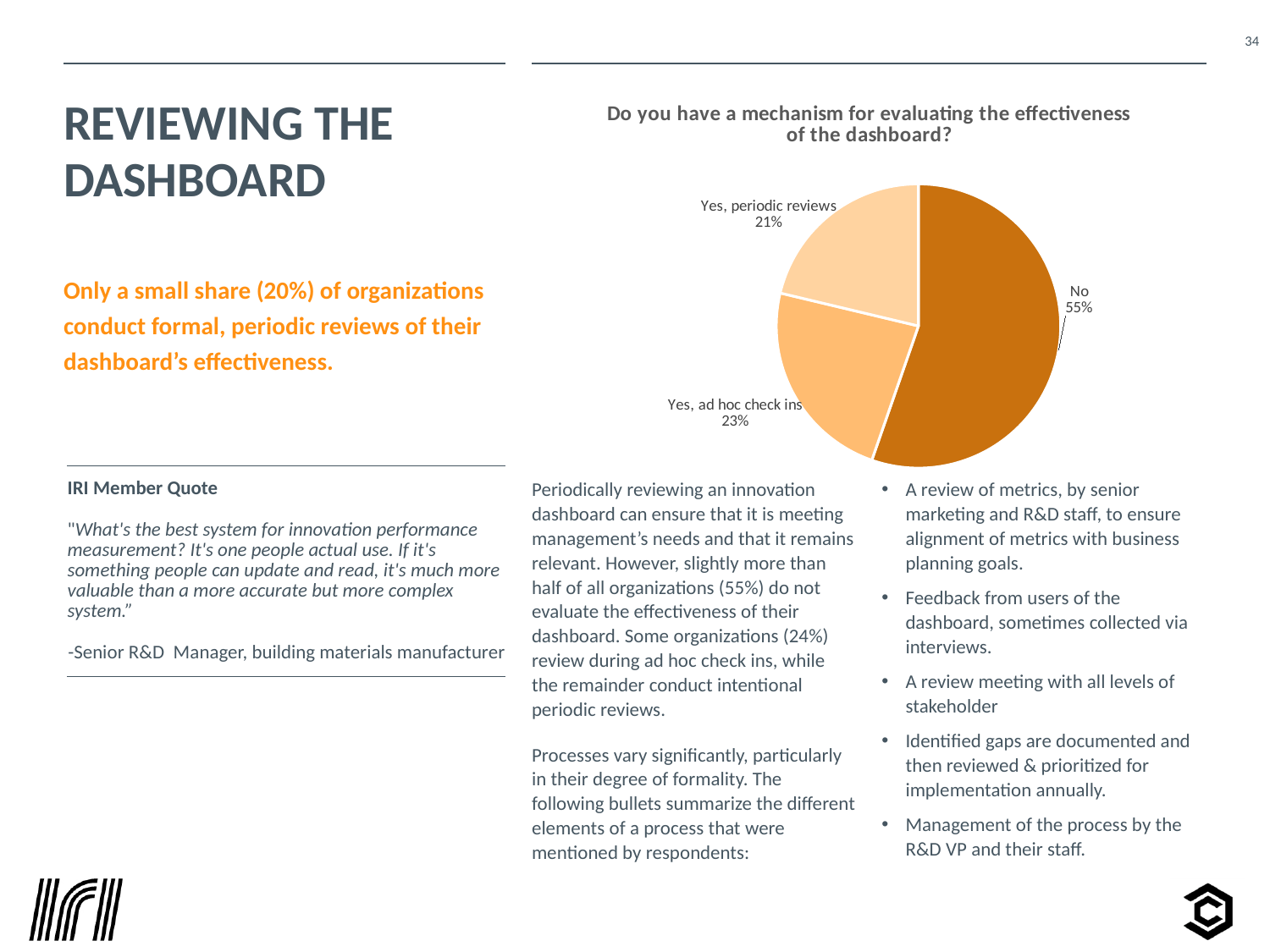
Which slice of the pie is the darkest orange? No What share of respondents answered "No"? 55% What kind of chart is shown on the slide? Pie chart Which is larger: the share for "No" or the share for "Yes, periodic reviews"? No How many slices does the pie chart have? 3 What is the difference in percentage points between "No" and "Yes, ad hoc check ins"? 32 percentage points What share of respondents answered "Yes, ad hoc check ins"? 23% What share of respondents answered "Yes, periodic reviews"? 21% Which response has the smallest slice of the pie? Yes, periodic reviews Which response has the largest slice of the pie? No What is the difference in percentage points between "Yes, ad hoc check ins" and "Yes, periodic reviews"? 2 percentage points What is the title of the chart? Do you have a mechanism for evaluating the effectiveness of the dashboard?